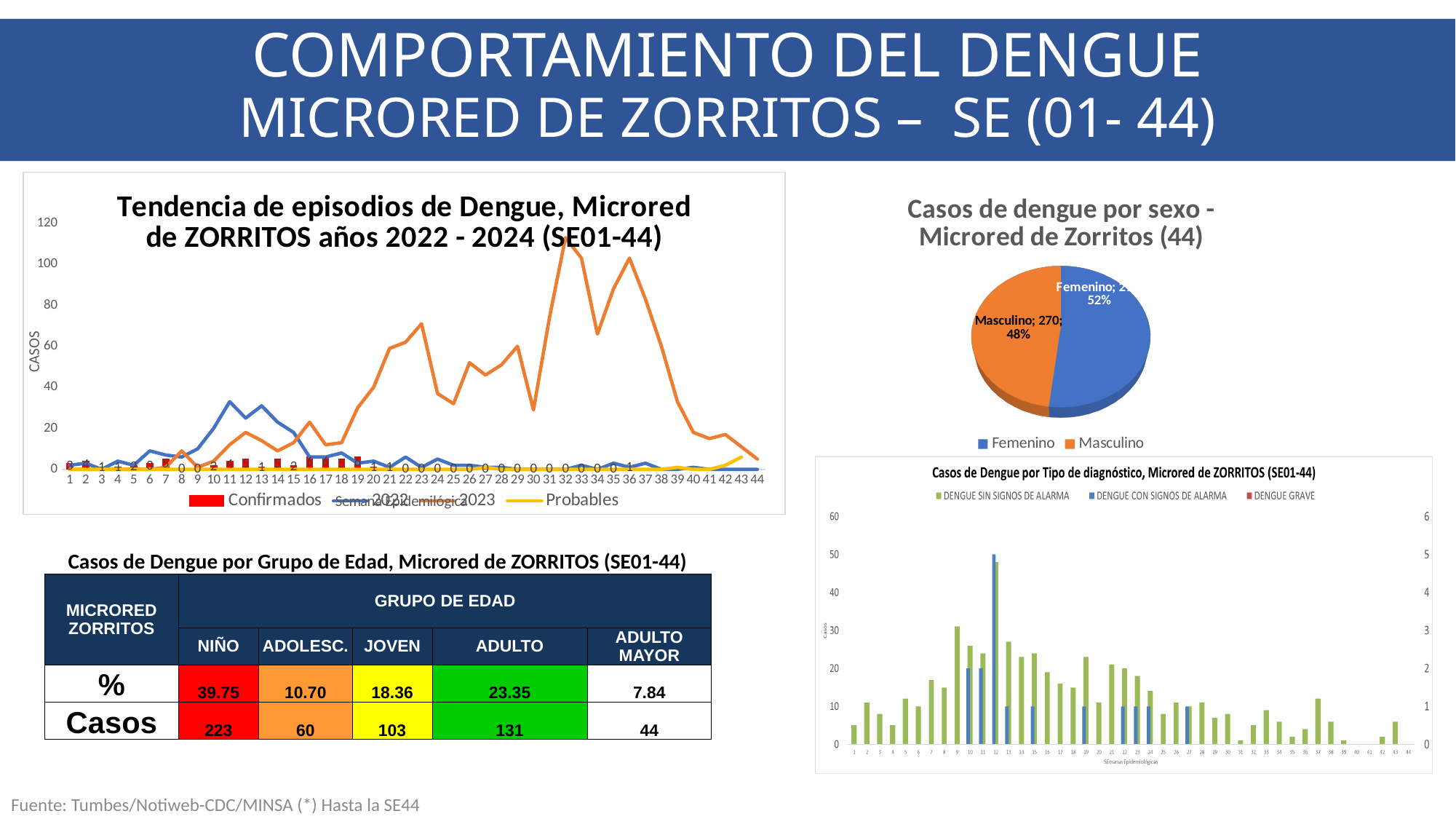
In the chart 'Tendencia de episodios de Dengue, Microred de ZORRITOS años 2022 - 2024 (SE01-44)', how many epidemiological weeks are shown on the x axis? 44 In the pie chart 'Casos de dengue por sexo - Microred de Zorritos (44)', what share of cases is Femenino? 52% What kind of chart is 'Tendencia de episodios de Dengue, Microred de ZORRITOS años 2022 - 2024 (SE01-44)'? Combination bar and line chart What is the y-axis title of the chart 'Tendencia de episodios de Dengue, Microred de ZORRITOS años 2022 - 2024 (SE01-44)'? CASOS How many series does the legend of the chart 'Casos de Dengue por Tipo de diagnóstico, Microred de ZORRITOS (SE01-44)' list? 3 How many entries does the legend of the pie chart 'Casos de dengue por sexo - Microred de Zorritos (44)' list? 2 In the pie chart 'Casos de dengue por sexo - Microred de Zorritos (44)', which slice is larger, Femenino or Masculino? Femenino In the chart 'Tendencia de episodios de Dengue, Microred de ZORRITOS años 2022 - 2024 (SE01-44)', is the value of the 2023 line at week 32 greater or less than 100? greater In the pie chart 'Casos de dengue por sexo - Microred de Zorritos (44)', what share of cases is Masculino? 48% How many series does the legend of the chart 'Tendencia de episodios de Dengue, Microred de ZORRITOS años 2022 - 2024 (SE01-44)' list? 4 In the chart 'Casos de Dengue por Tipo de diagnóstico, Microred de ZORRITOS (SE01-44)', in which week is the DENGUE SIN SIGNOS DE ALARMA bar the tallest? 12 In the pie chart 'Casos de dengue por sexo - Microred de Zorritos (44)', how many cases are Masculino? 270